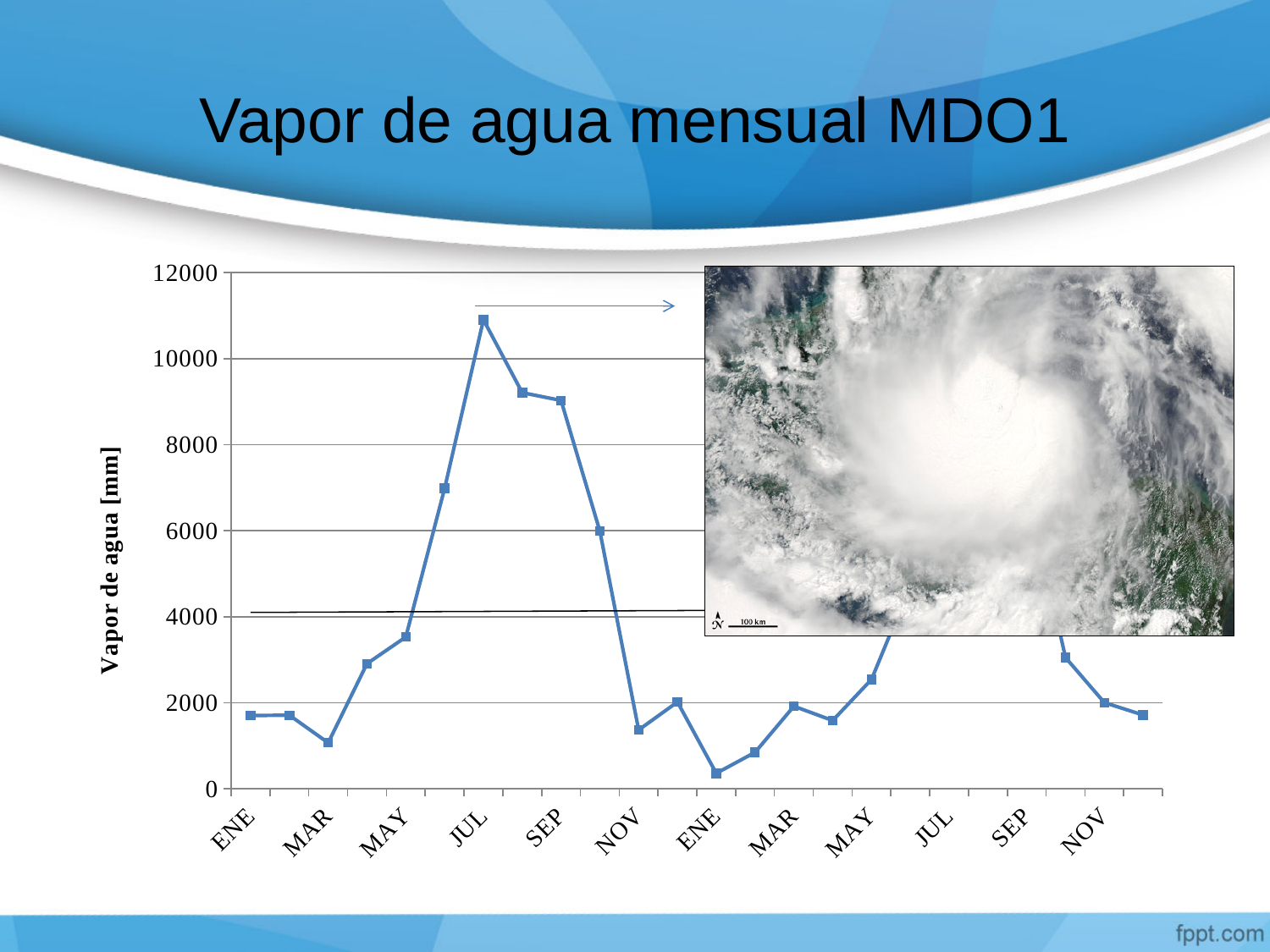
Among the points visible on the chart, which month has the lowest value? ENE (second year) What kind of chart is shown on the slide? line chart Is the value for the second ENE greater or less than 2000? less Is the value for the first SEP greater or less than 8000? greater Do the values rise or fall between the first MAY and the first JUL? rise Among the points visible on the chart, which month has the highest value? JUL (first year) Is the value for the first JUL greater or less than 10000? greater What is the title of the chart on the slide? Vapor de agua mensual MDO1 Which of the visible points has the highest value, the first JUL or the first SEP? the first JUL What is the label of the vertical axis of the chart? Vapor de agua [mm]